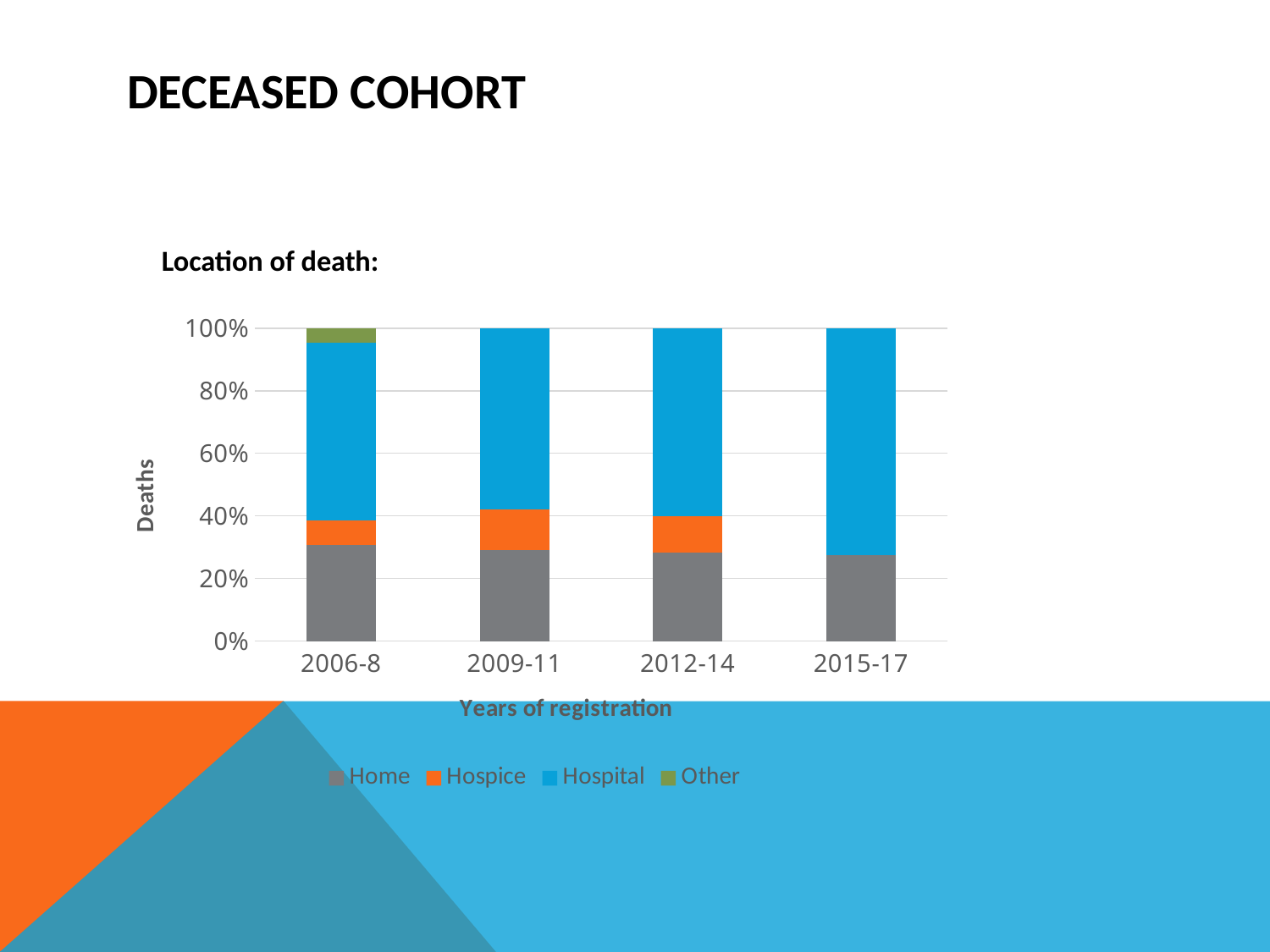
Is the Hospital share of deaths for 2015-17 greater or less than 60%? greater Which year-of-registration period has the largest Hospital share of deaths? 2015-17 What is the title of the y axis? Deaths How many year-of-registration categories are shown on the x axis? 4 How many series does the legend list? 4 Does the Hospital share of deaths rise or fall from 2006-8 to 2015-17? rise What are the series listed in the legend? Home, Hospice, Hospital, Other Is the Home share of deaths for 2015-17 greater or less than 40%? less What kind of chart is shown on the slide? Stacked bar chart Is the Home share of deaths for 2006-8 greater or less than 40%? less Is the Hospital share of deaths larger in 2006-8 or in 2015-17? 2015-17